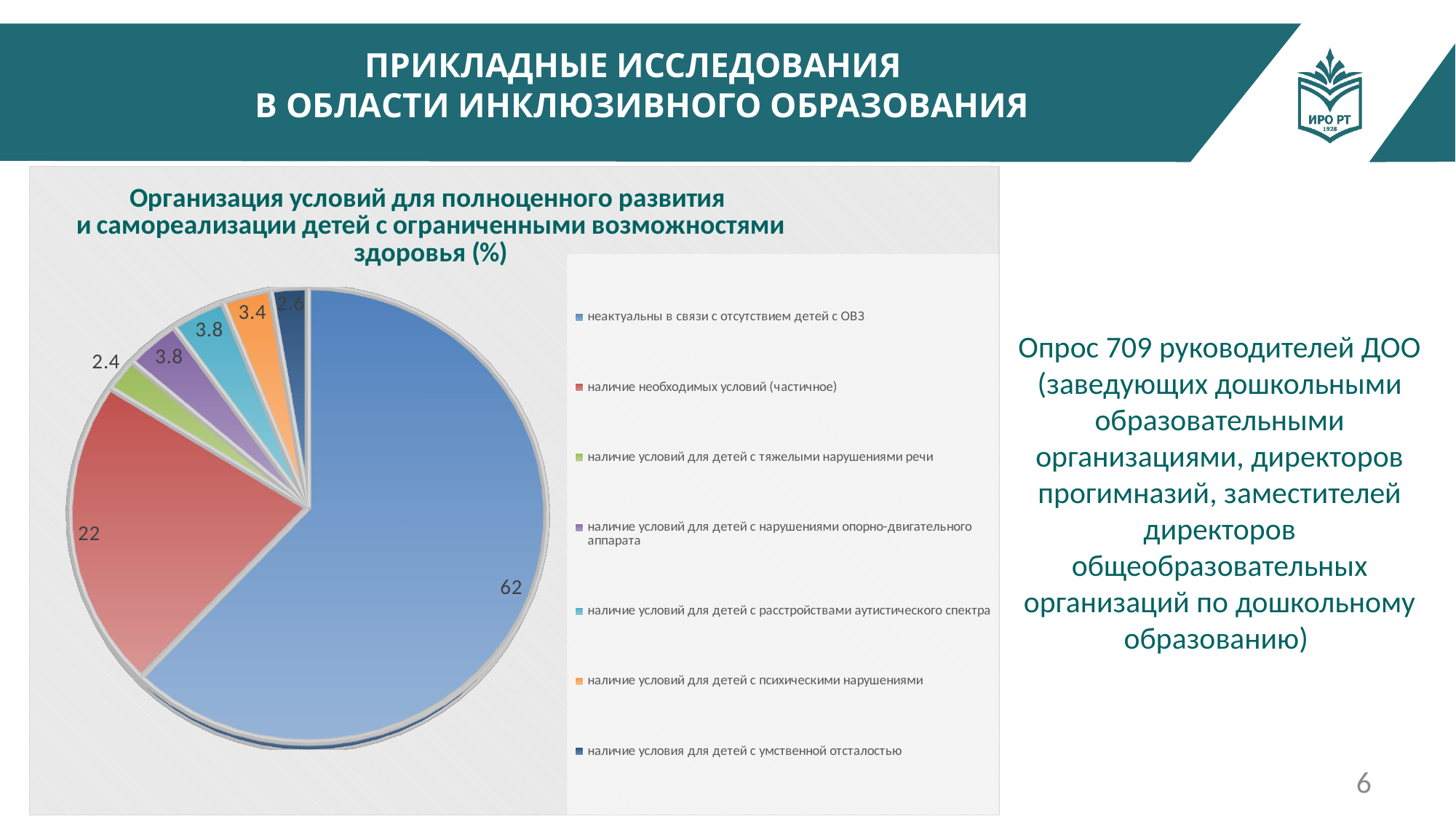
How many slices does the pie chart have? 7 What is the value for "наличие условия для детей с умственной отсталостью"? 2.6 Which category has the largest slice of the pie? неактуальны в связи с отсутствием детей с ОВЗ What colour is the slice for "наличие условий для детей с расстройствами аутистического спектра"? light blue Which is larger: the value for "наличие условий для детей с психическими нарушениями" or for "наличие условия для детей с умственной отсталостью"? наличие условий для детей с психическими нарушениями What is the value for "наличие условий для детей с тяжелыми нарушениями речи"? 2.4 What is the value for "наличие условий для детей с психическими нарушениями"? 3.4 What is the value for "неактуальны в связи с отсутствием детей с ОВЗ"? 62 What kind of chart is shown on the slide? pie chart What is the difference between the values for "неактуальны в связи с отсутствием детей с ОВЗ" and "наличие необходимых условий (частичное)"? 40 Which category has the smallest slice of the pie? наличие условий для детей с тяжелыми нарушениями речи What is the value for "наличие необходимых условий (частичное)"? 22